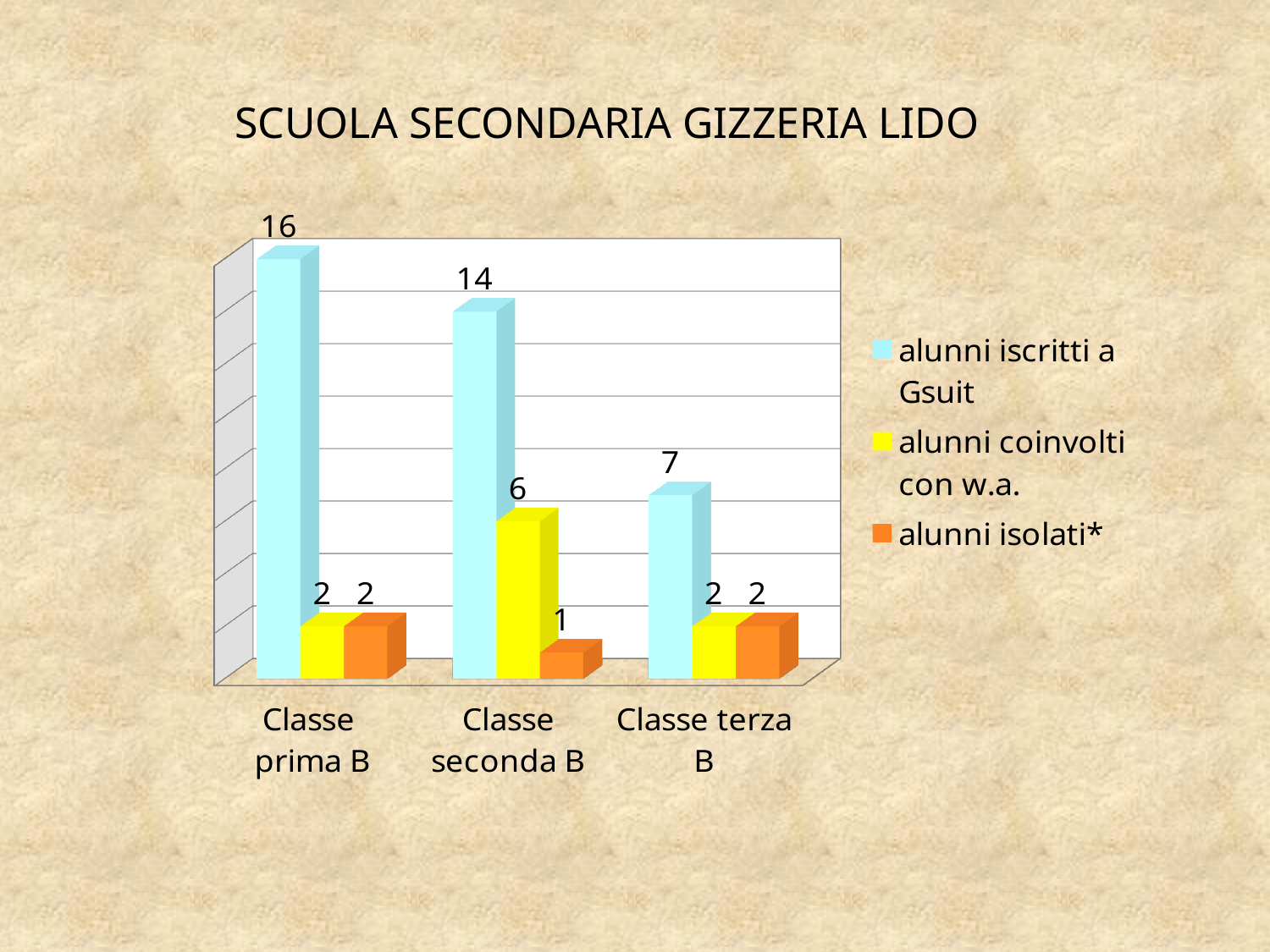
How many classes are shown on the x axis? 3 Which class has the lowest value for 'alunni isolati*'? Classe seconda B What is the value for 'alunni isolati*' in Classe seconda B? 1 How many series does the legend list? 3 What is the value for 'alunni iscritti a Gsuit' in Classe terza B? 7 What kind of chart is shown on the slide? Bar chart What is the value for 'alunni iscritti a Gsuit' in Classe prima B? 16 What is the value for 'alunni coinvolti con w.a.' in Classe seconda B? 6 Which class has the highest value for 'alunni iscritti a Gsuit'? Classe prima B What is the difference between 'alunni iscritti a Gsuit' and 'alunni coinvolti con w.a.' in Classe seconda B? 8 Which is larger: 'alunni coinvolti con w.a.' in Classe seconda B or in Classe terza B? Classe seconda B What is the difference between 'alunni iscritti a Gsuit' in Classe prima B and Classe seconda B? 2